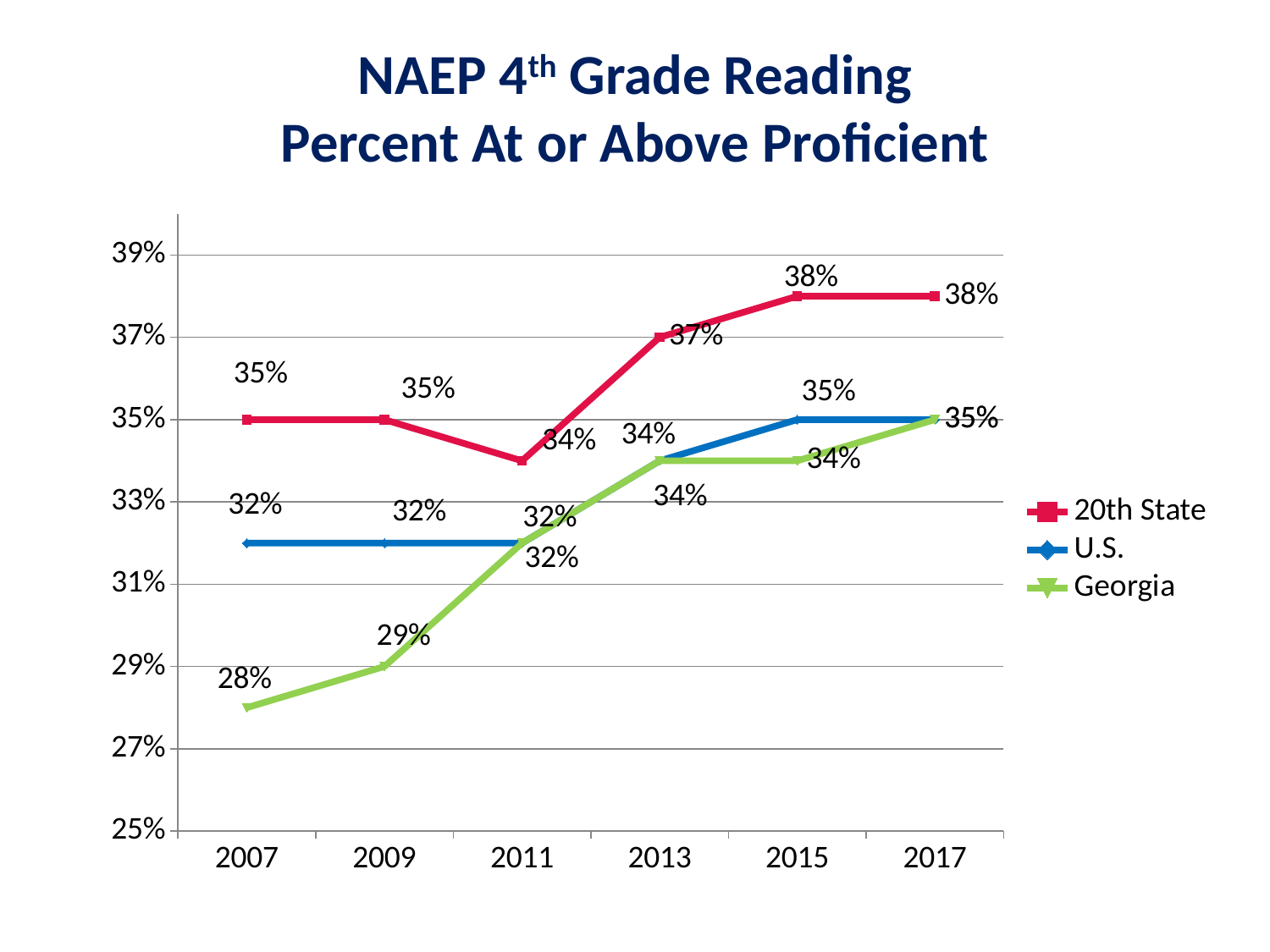
What was the U.S. value in 2013? 34% What is the difference between the 20th State value and Georgia's value in 2007? 7 percentage points What type of chart is shown on the slide? Line chart What was the 20th State value in 2015? 38% How many years are plotted along the x axis? 6 Which series is shown in red? 20th State Does Georgia's line generally rise or fall from 2007 to 2017? Rise What was Georgia's value in 2009? 29% Which was higher in 2015, the U.S. value or Georgia's value? U.S. What was Georgia's percent at or above proficient in 2007? 28% How many series does the legend list? 3 In which year was Georgia's value lowest? 2007